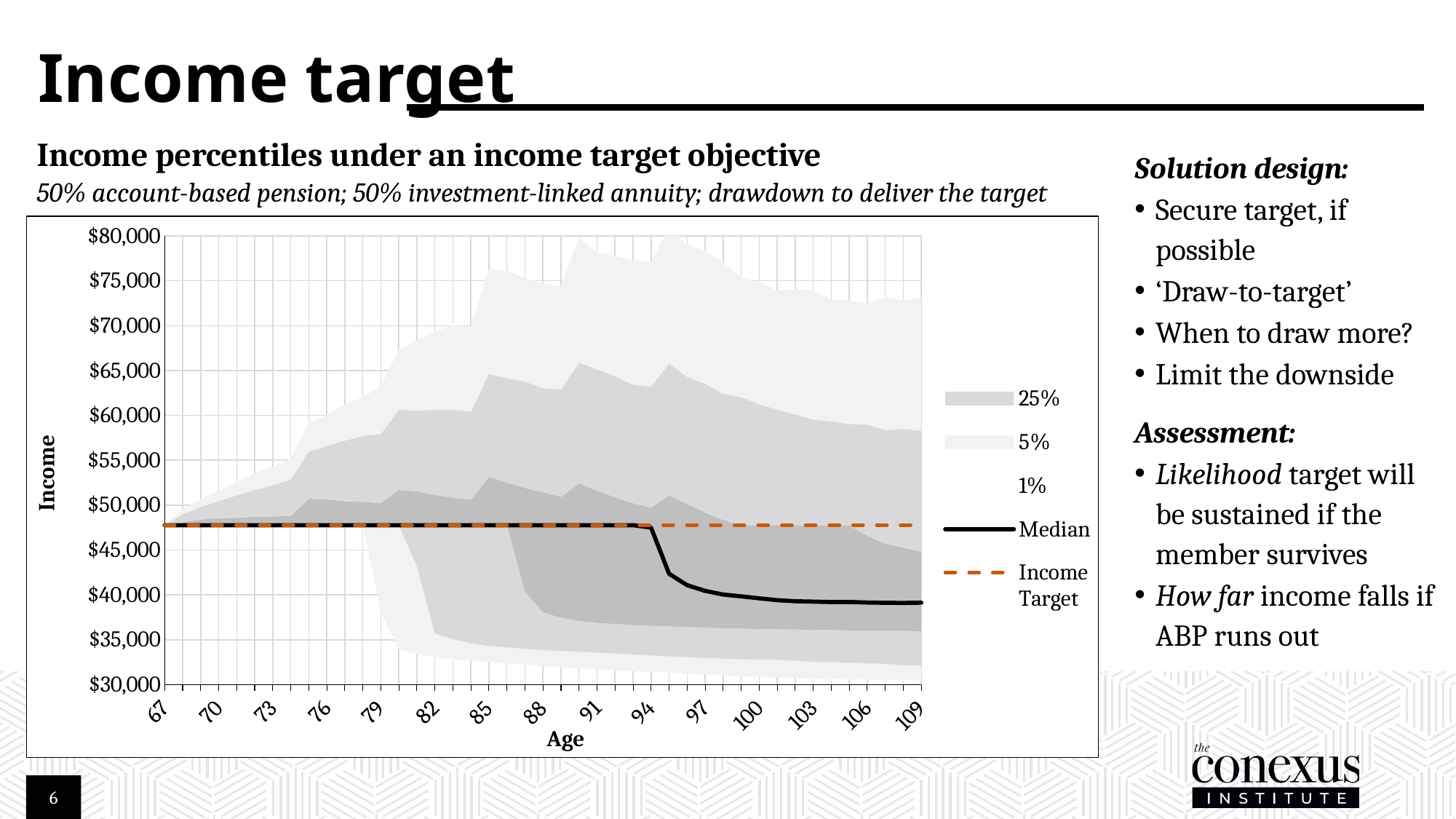
Is the Income Target value greater or less than $50,000? less What is the lowest value shown on the y axis of the chart? $30,000 Is the Median value at age 67 greater or less than $50,000? less What kind of chart is shown on the slide? Area chart with line series Is the Income Target value greater or less than $45,000? greater What is the label of the x axis of the chart? Age What is the highest value shown on the y axis of the chart? $80,000 How many entries does the chart legend list? 5 At age 100, which is larger, the Median or the Income Target? Income Target Does the Median line rise or fall between age 94 and age 109? fall What is the label of the y axis of the chart? Income